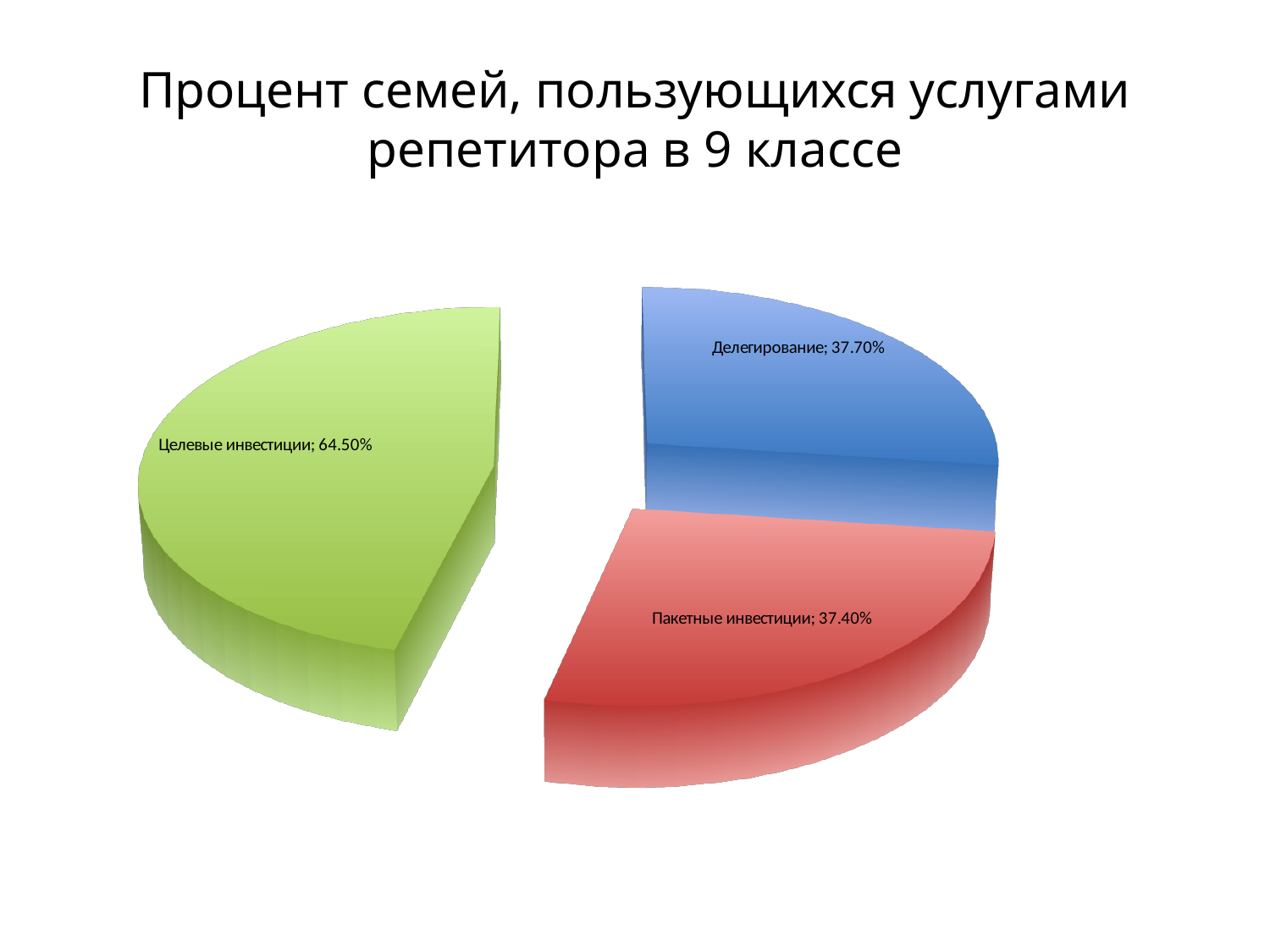
What is the title of the chart on the slide? Процент семей, пользующихся услугами репетитора в 9 классе How many slices does the pie chart have? 3 What is the value shown for Делегирование? 37.70% Which category has the highest value in the pie chart? Целевые инвестиции Which category has the lowest value in the pie chart? Пакетные инвестиции What colour is the slice for Целевые инвестиции? green What is the difference between the values for Делегирование and Пакетные инвестиции? 0.30% What is the difference between the values for Целевые инвестиции and Делегирование? 26.80% What is the value shown for Целевые инвестиции? 64.50% What is the value shown for Пакетные инвестиции? 37.40% What kind of chart is shown on the slide? pie chart Which is larger, the value for Делегирование or the value for Пакетные инвестиции? Делегирование